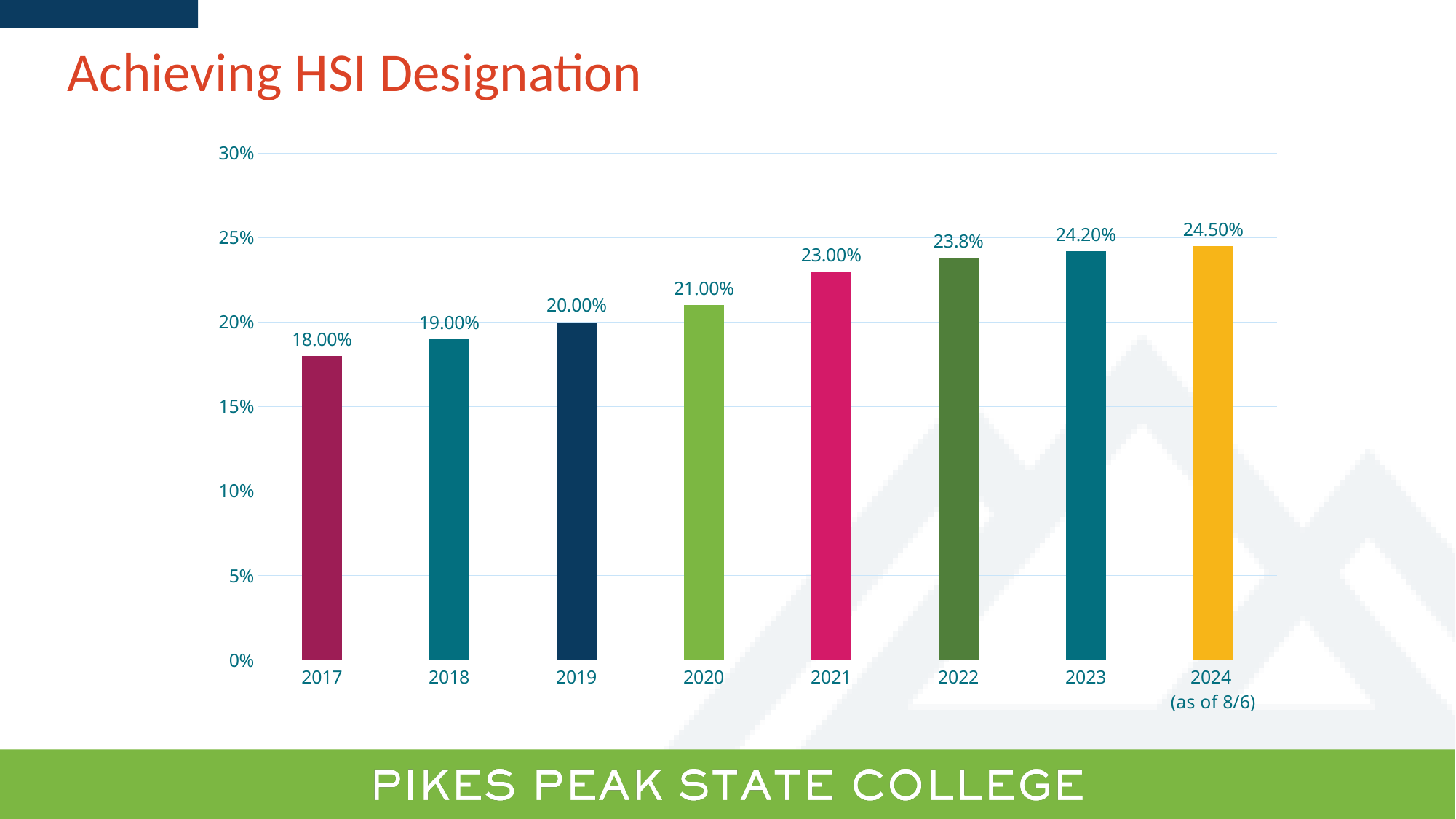
What is the value for 2022? 23.8% Is the value for 2018 greater or less than 20%? less What is the value for 2017? 18.00% What is the difference between the values for 2023 and 2017? 6.20% Which year has the lowest value? 2017 What is the value for 2024 (as of 8/6)? 24.50% Which year has the highest value? 2024 (as of 8/6) What is the value for 2021? 23.00% What kind of chart is shown on the slide? bar chart How many years are shown on the x axis? 8 Which is larger, the value for 2019 or the value for 2020? 2020 Do the values rise or fall from 2017 to 2024? rise